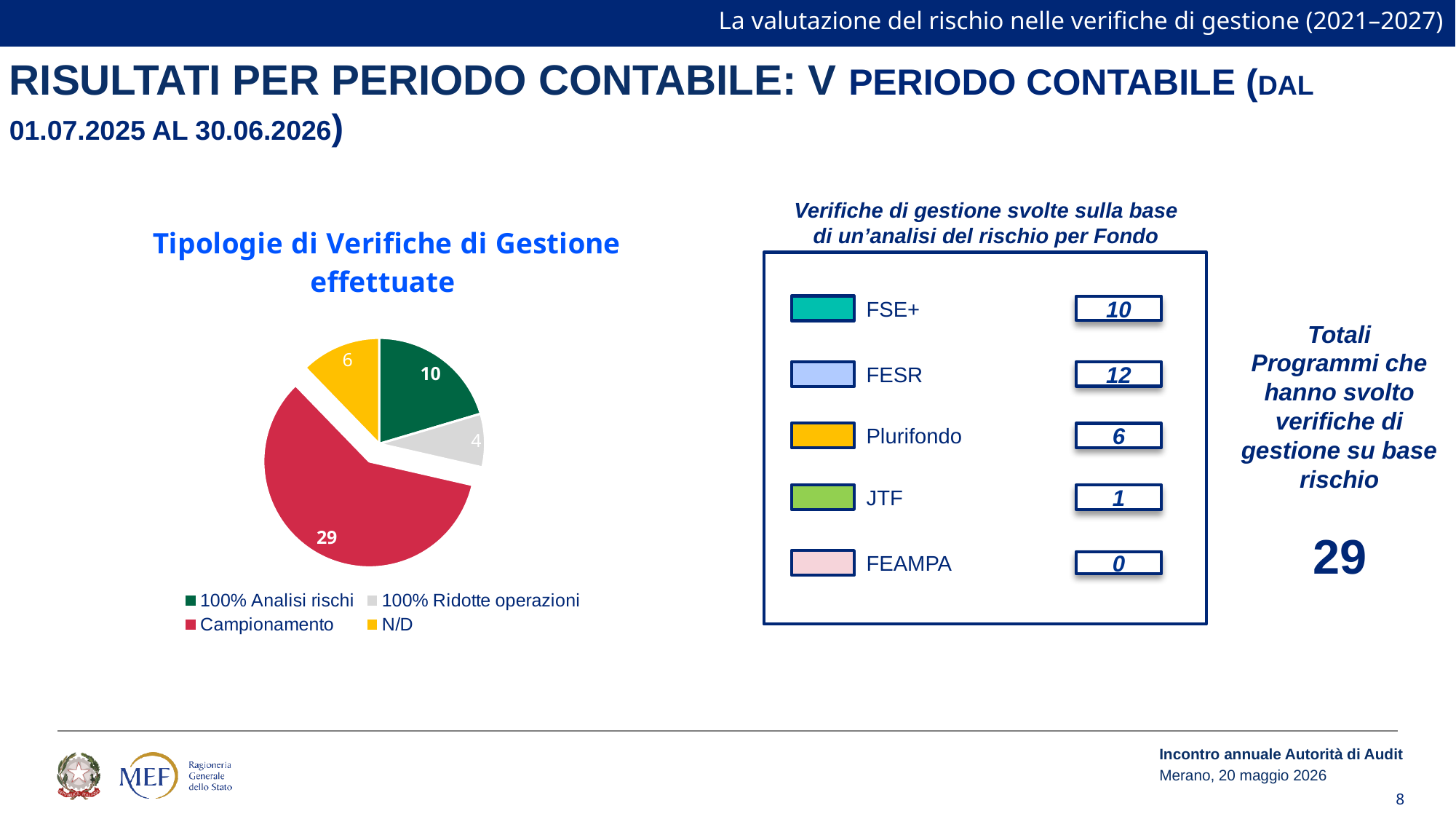
What is the total of all slices in the pie chart? 49 What is the difference between the values for Campionamento and 100% Analisi rischi in the pie chart? 19 In the pie chart, what is the value for 100% Ridotte operazioni? 4 In the pie chart, what is the value for N/D? 6 What colour is the Campionamento slice in the pie chart? red In the pie chart, what is the value for Campionamento? 29 Which category has the smallest slice in the pie chart? 100% Ridotte operazioni What type of chart is "Tipologie di Verifiche di Gestione effettuate"? pie chart In the pie chart, what is the value for 100% Analisi rischi? 10 In the pie chart, which is larger: N/D or 100% Ridotte operazioni? N/D How many categories does the pie chart show? 4 Which category has the largest slice in the pie chart? Campionamento